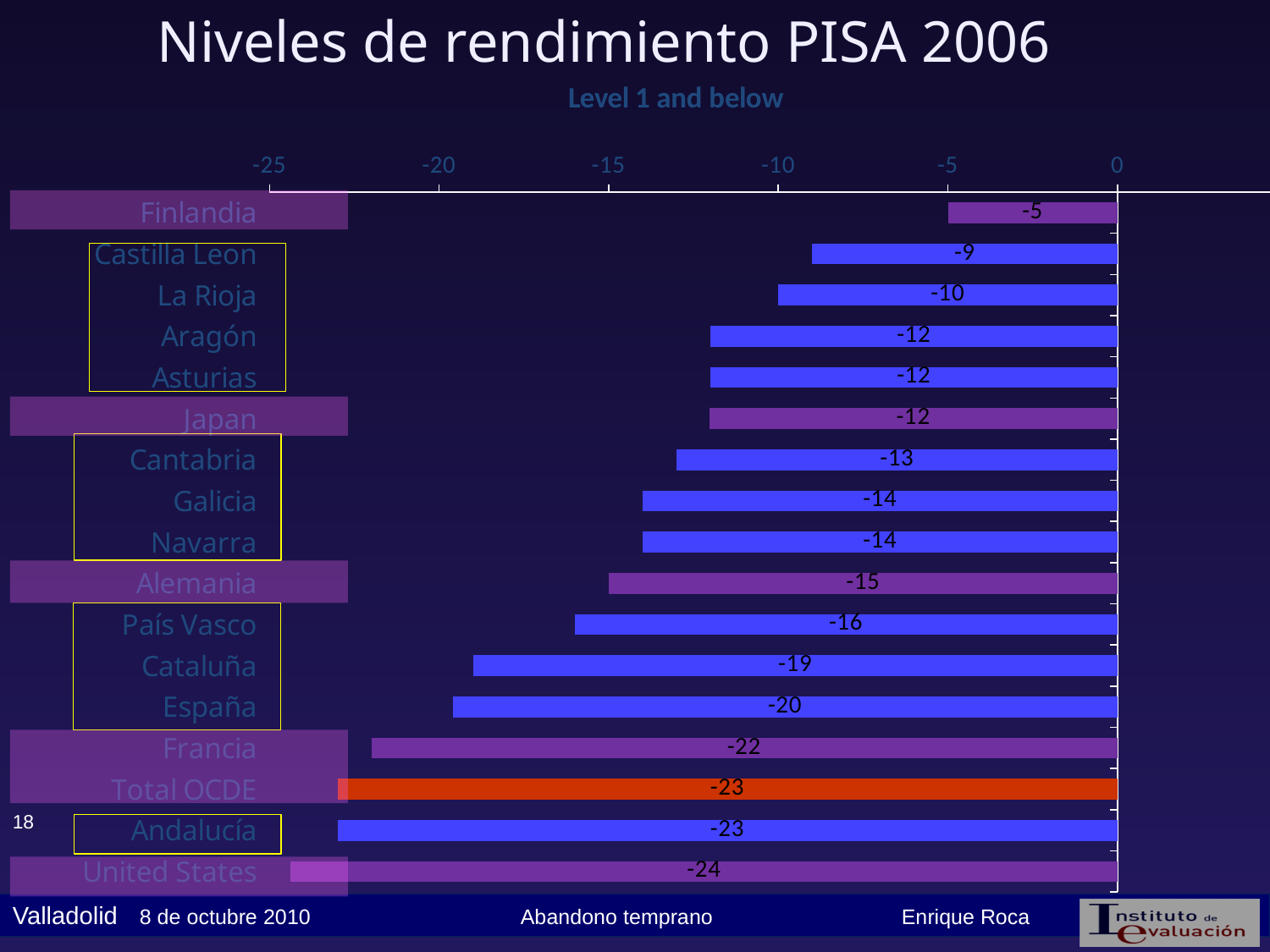
Which category has the longest bar (the most negative value)? United States What is the value shown for España? -20 What is the value shown for Cataluña? -19 Which has a longer bar, Francia or Alemania? Francia How many categories are plotted in the chart? 17 What is the difference between the values for España and Andalucía? 3 Which category has the shortest bar (the value closest to zero)? Finlandia What is the value shown for Finlandia? -5 What is the value shown for Total OCDE? -23 What is the difference between the values for Finlandia and United States? 19 What type of chart is shown on the slide? Bar chart What is the subtitle printed above the chart? Level 1 and below